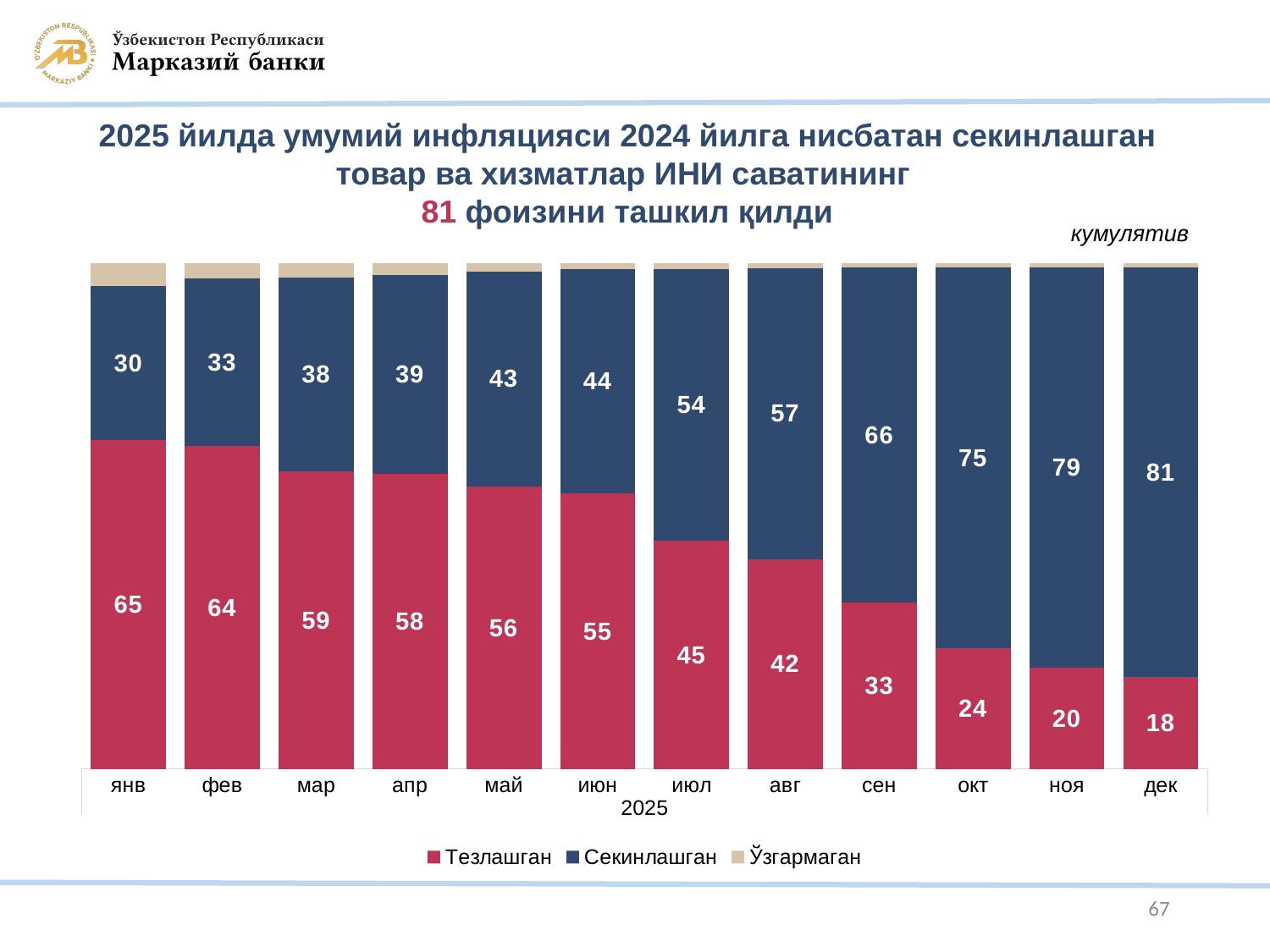
What type of chart is shown on the slide? Stacked bar chart Which is larger in авг: Тезлашган or Секинлашган? Секинлашган What is the value of Тезлашган for янв? 65 What is the difference between the Секинлашган values for дек and янв? 51 Does the Тезлашган value rise or fall from янв to дек? Fall In which month is the Тезлашган value lowest? дек What is the value of Тезлашган for сен? 33 How many months are shown on the x axis? 12 What is the value of Секинлашган for дек? 81 In which month is the Секинлашган value highest? дек What is the value of Секинлашган for июл? 54 How many series does the legend list? 3